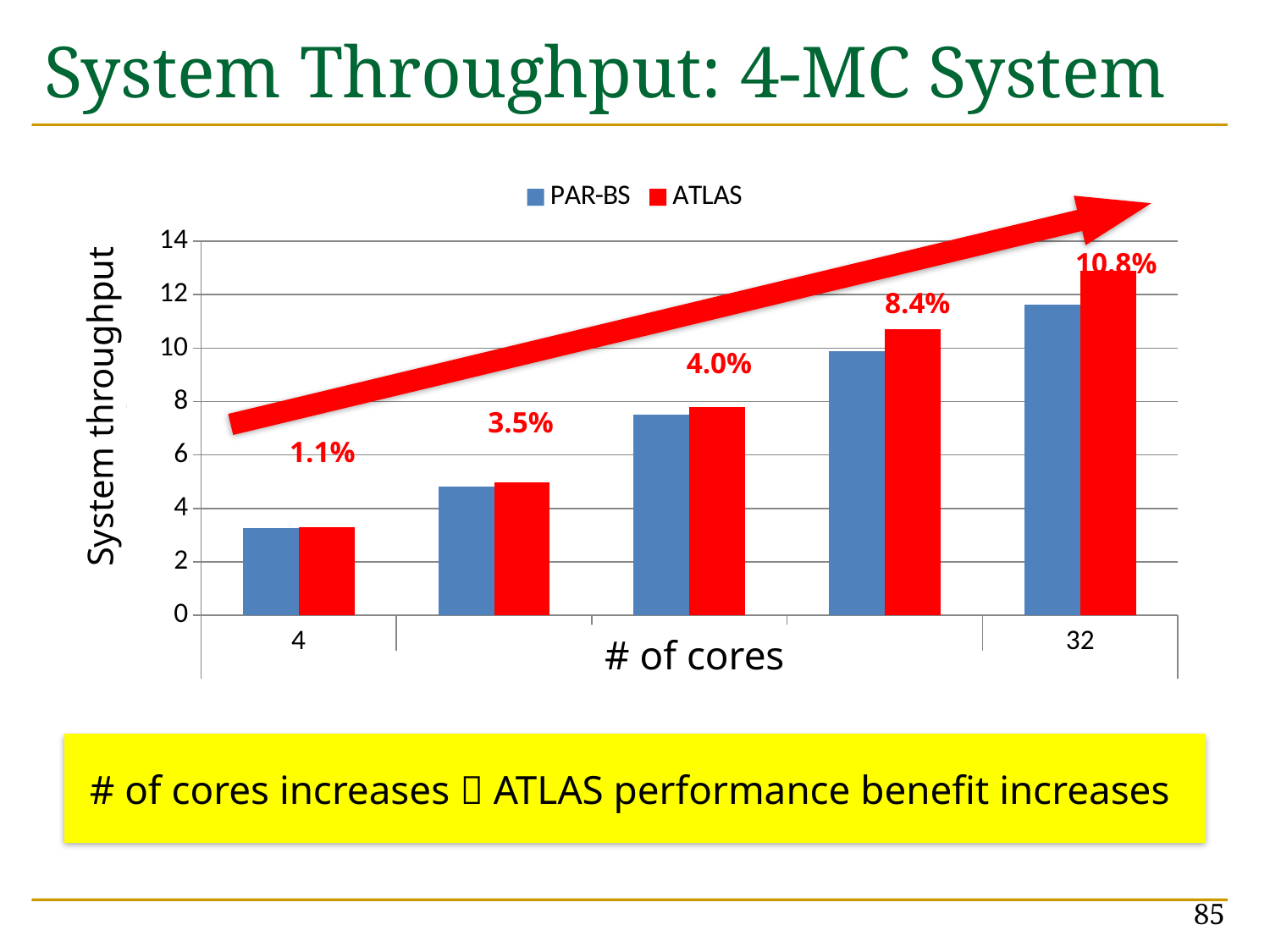
Does system throughput rise or fall as the number of cores increases along the x axis? rise What are the two series named in the legend? PAR-BS and ATLAS What is the label on the y axis? System throughput Is the PAR-BS value for 32 cores greater or less than 10? greater At 32 cores, which series has the larger system throughput, PAR-BS or ATLAS? ATLAS Is the PAR-BS value for 4 cores greater or less than 4? less What kind of chart is shown on the slide? bar chart What percentage label is printed above the bars for 4 cores? 1.1% Is the ATLAS value for 32 cores greater or less than 12? greater What percentage label is printed above the bars for 32 cores? 10.8% How many groups of bars (core counts) are plotted on the chart? 5 How many series does the legend list? 2